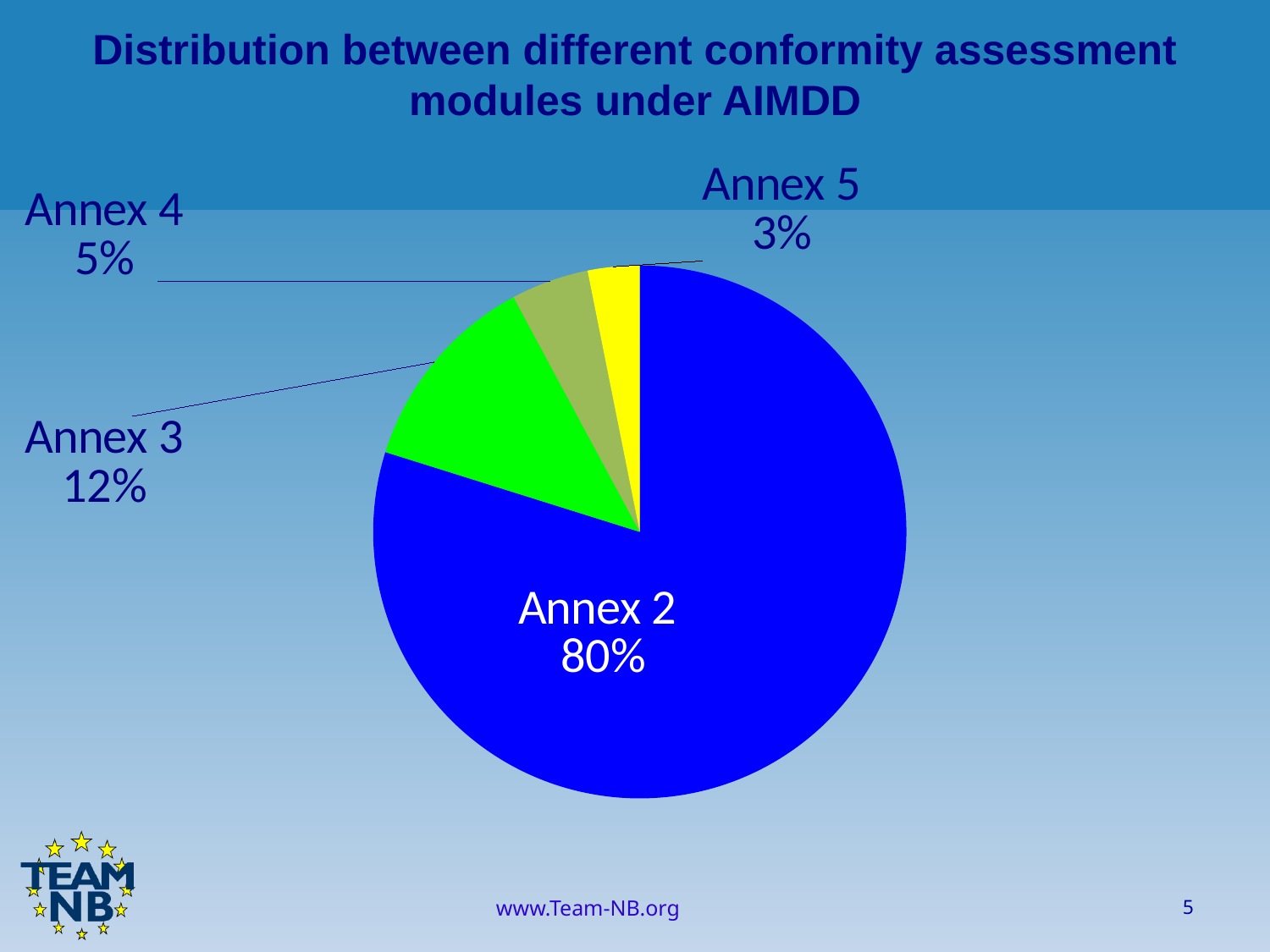
What is the difference in percentage points between Annex 4 and Annex 5? 2 What is the value shown for Annex 3? 12% What is the difference in percentage points between Annex 2 and Annex 3? 68 What is the title of the chart? Distribution between different conformity assessment modules under AIMDD What is the value shown for Annex 4? 5% Which annex has the smallest share of the pie? Annex 5 Which is larger, the share for Annex 3 or the share for Annex 4? Annex 3 How many slices does the pie chart have? 4 What kind of chart is shown on the slide? Pie chart What share of the pie does Annex 2 represent? 80% Which annex has the largest share of the pie? Annex 2 What is the value shown for Annex 5? 3%